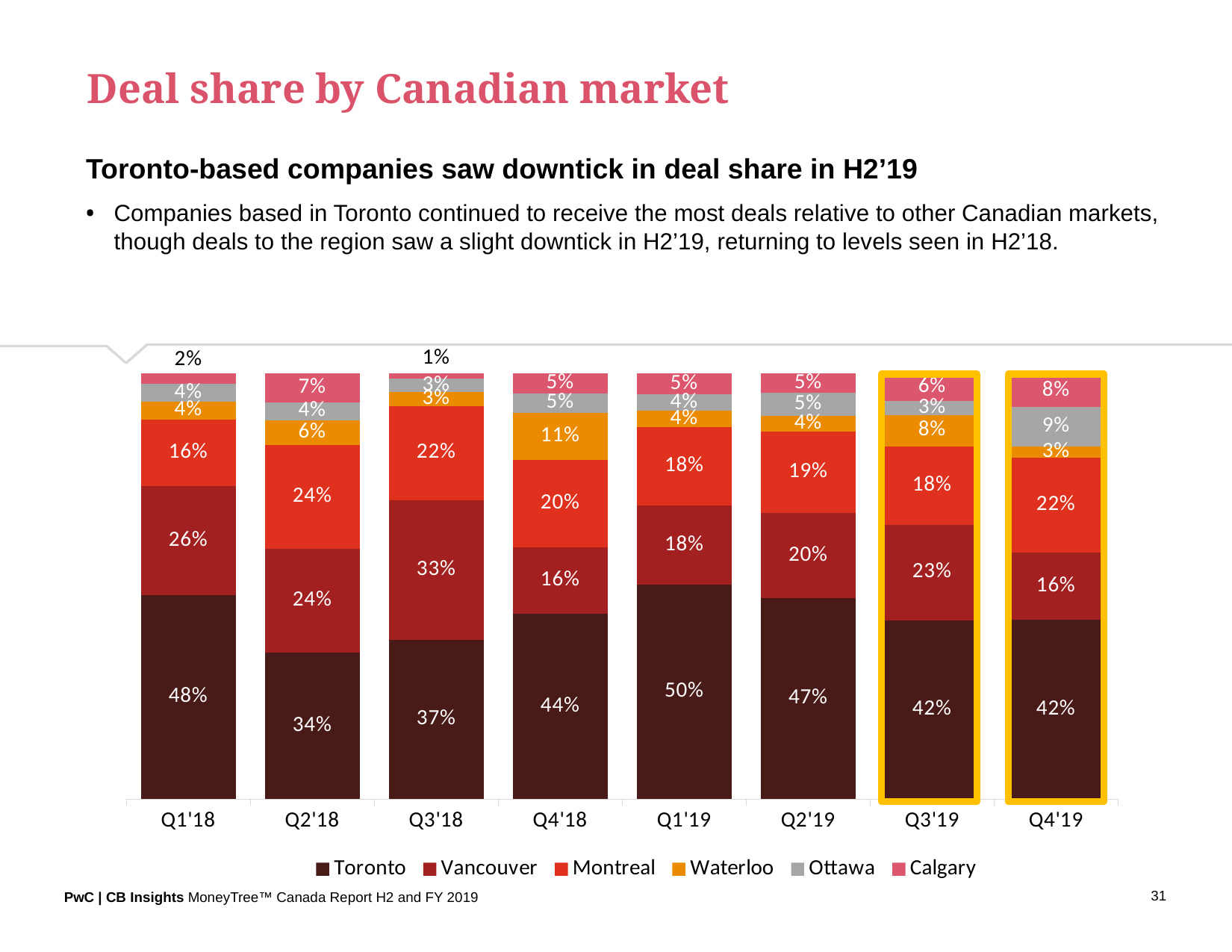
Which two quarters are highlighted with a yellow outline? Q3'19 and Q4'19 What is Vancouver's deal share in Q3'18? 33% In which quarter is Toronto's deal share highest? Q1'19 How many series does the legend list? 6 What is Toronto's deal share in Q1'19? 50% What is Ottawa's deal share in Q4'19? 9% What is Waterloo's deal share in Q4'18? 11% What kind of chart is shown on the slide? Stacked bar chart Which is larger in Q4'19: Montreal's deal share or Vancouver's deal share? Montreal In which quarter is Toronto's deal share lowest? Q2'18 How many quarters are shown on the x axis? 8 What is the difference between Toronto's deal share in Q2'19 and Q3'19? 5%